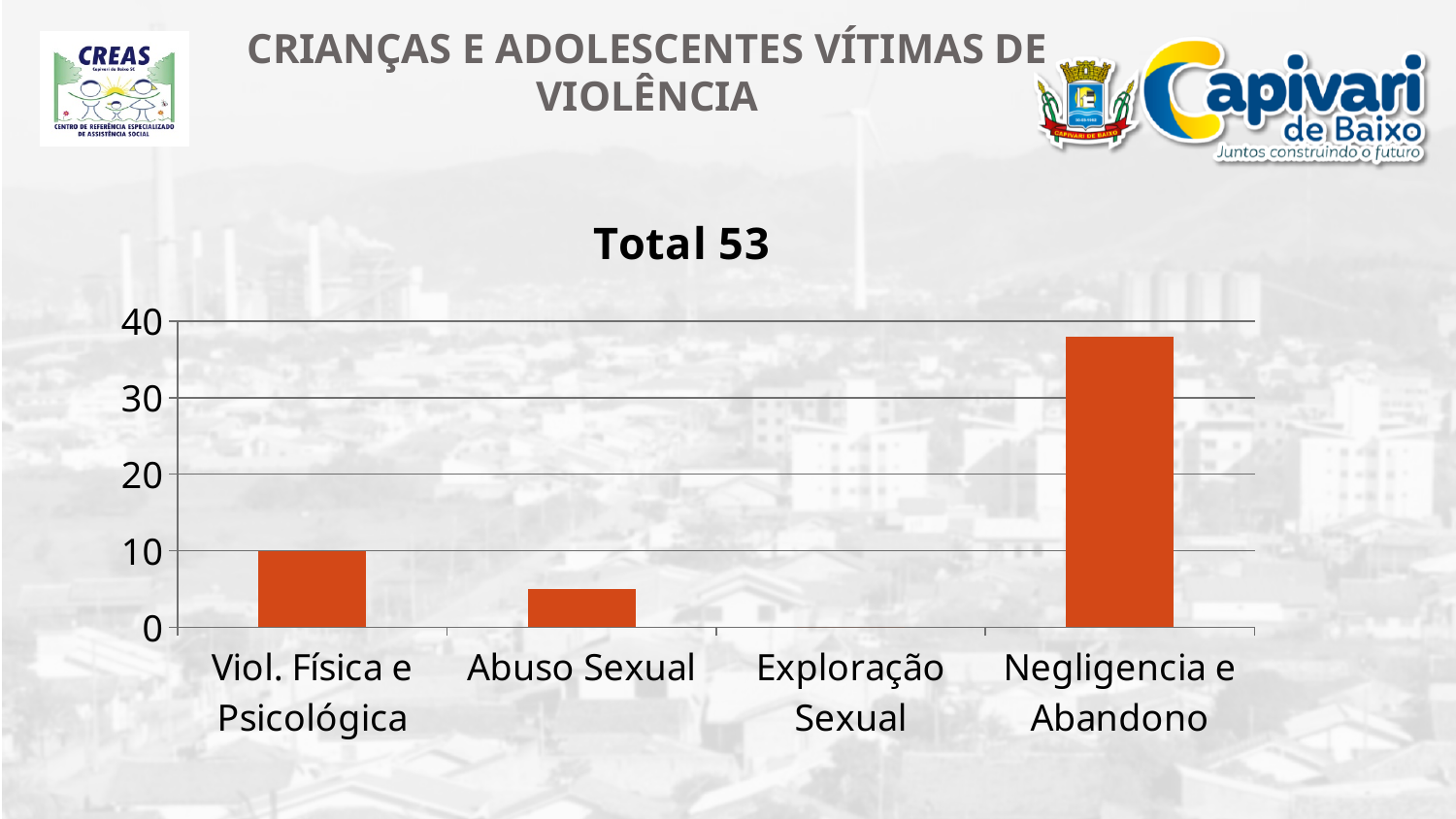
Is the value for Negligencia e Abandono greater or less than 30? greater What is the value for Viol. Física e Psicológica? 10 Which category has the highest value in the chart? Negligencia e Abandono What colour are the bars in the chart? orange What is the title of the chart? Total 53 Which is larger, the value for Viol. Física e Psicológica or the value for Abuso Sexual? Viol. Física e Psicológica What kind of chart is shown on the slide? bar chart Which category has the lowest value in the chart? Exploração Sexual What is the value for Exploração Sexual? 0 Is the value for Negligencia e Abandono greater or less than 40? less How many categories are shown on the x axis of the chart? 4 Is the value for Abuso Sexual greater or less than 10? less